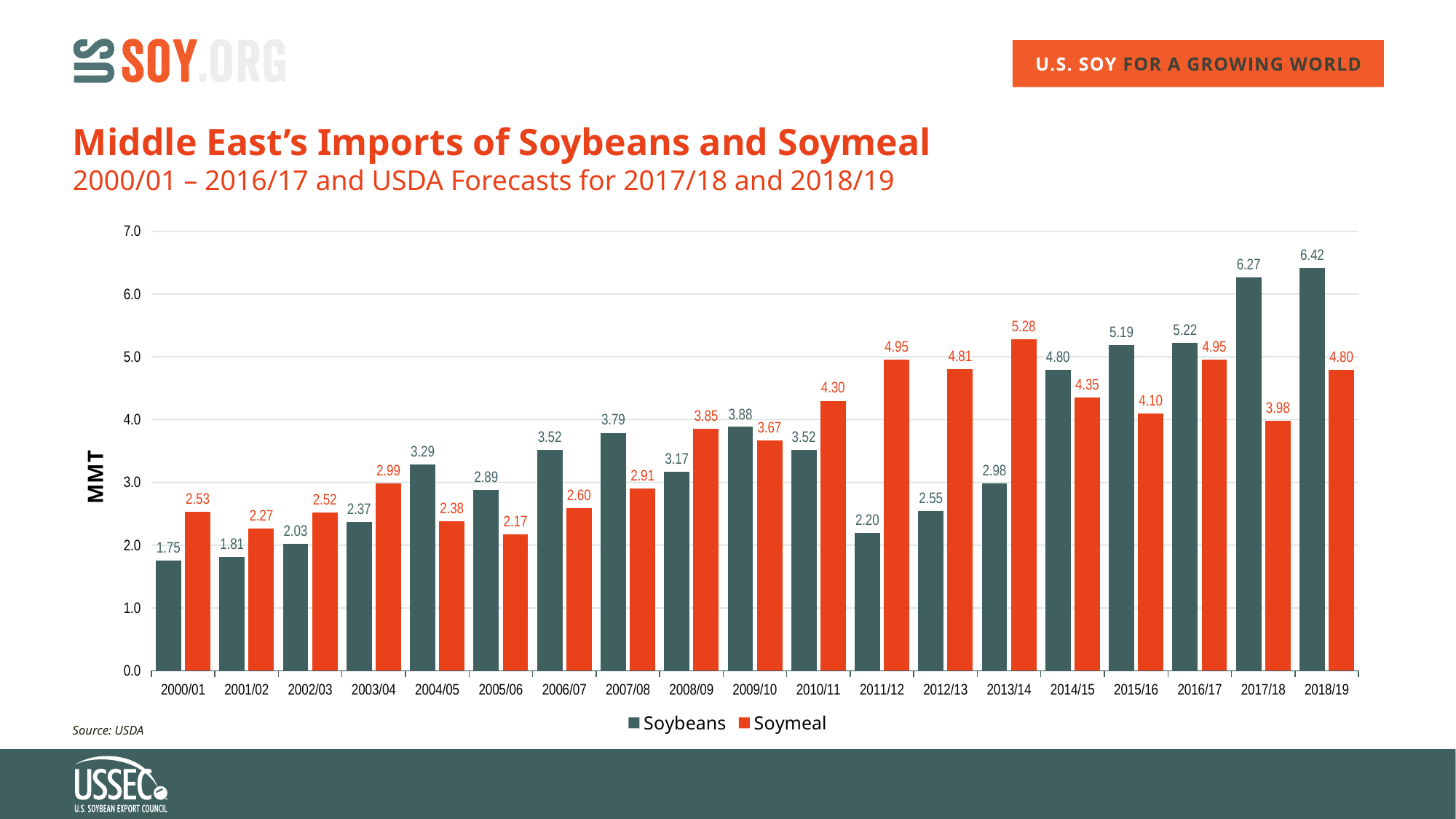
What kind of chart is shown on the slide? Bar chart What is the Soybeans import value for 2018/19? 6.42 In which year are Soymeal imports lowest? 2005/06 What is the difference between Soybeans and Soymeal imports in 2018/19? 1.62 What is the Soymeal import value for 2013/14? 5.28 What is the label on the y axis? MMT How many series does the legend list? 2 Which is larger in 2011/12, Soybeans or Soymeal imports? Soymeal In which year are Soymeal imports highest? 2013/14 What is the Soybeans import value for 2011/12? 2.20 How many marketing years are shown on the x axis? 19 In which year are Soybeans imports highest? 2018/19